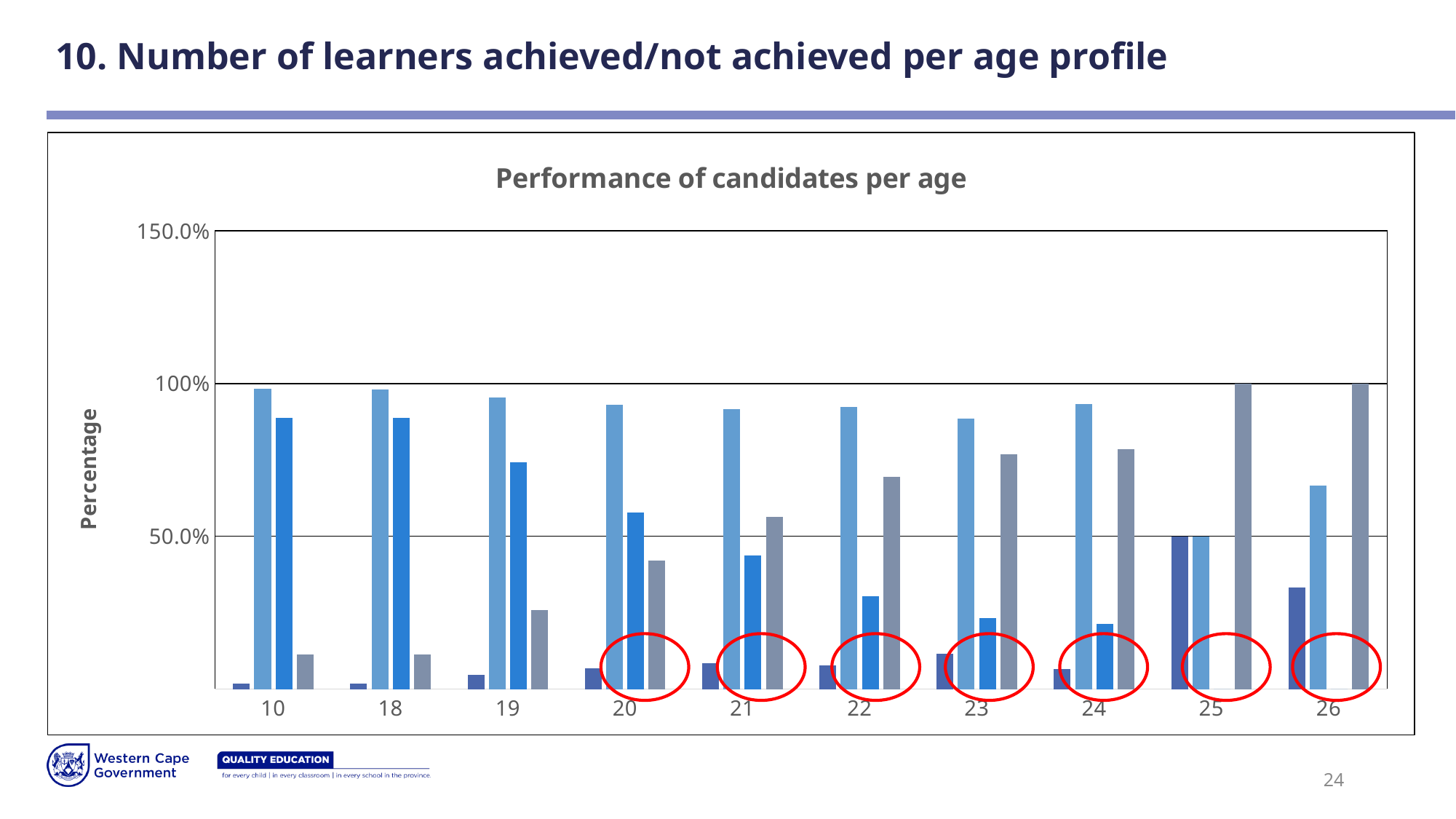
Which age has the tallest dark blue bar? 25 What is the title of the chart? Performance of candidates per age For age 19, which is larger: the light blue bar or the grey bar? the light blue bar Do the grey bars generally rise or fall as age increases along the x axis? rise How many age categories are shown on the x axis of the chart? 10 Is the value of the grey bar for age 20 greater or less than 50%? less What kind of chart is shown on the slide? bar chart What is the label on the vertical axis of the chart? Percentage Is the value of the light blue bar for age 10 greater or less than 50%? greater Is the value of the dark blue bar for age 26 greater or less than 50%? less For age 26, which is larger: the light blue bar or the grey bar? the grey bar